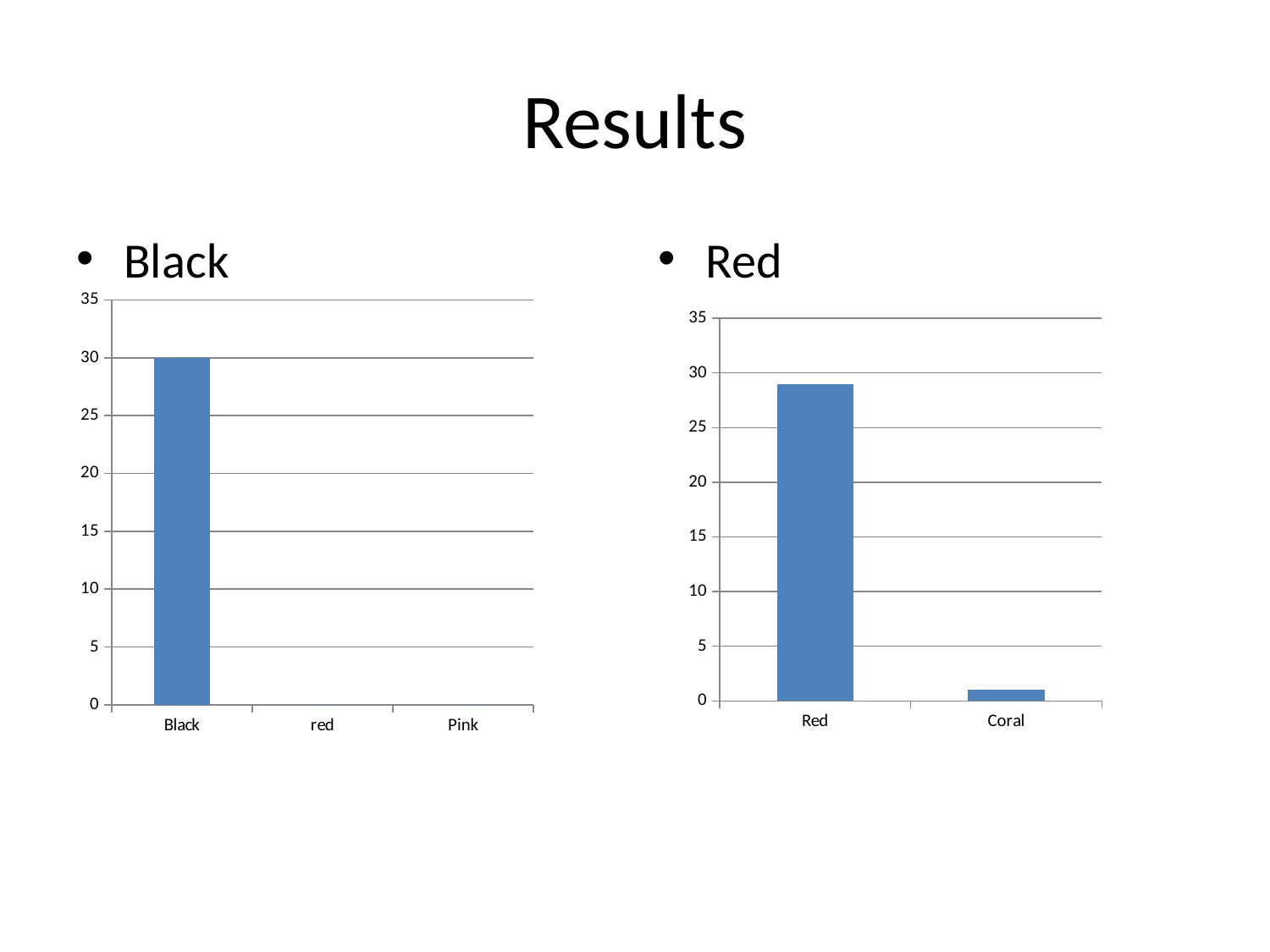
On the right chart, is the value for Coral greater or less than 5? less On the left chart, which category has the highest value? Black What kind of chart is the left chart? bar chart On the right chart, which category has the highest value? Red How many categories are shown on the x axis of the left chart? 3 On the right chart, which category has the lowest value? Coral On the right chart, is the value for Red greater or less than 25? greater On the left chart, what is the value for Black? 30 What is the maximum value shown on the y axis of the right chart? 35 On the right chart, is the value for Red greater or less than 30? less On the right chart, which is larger, Red or Coral? Red How many categories are shown on the x axis of the right chart? 2